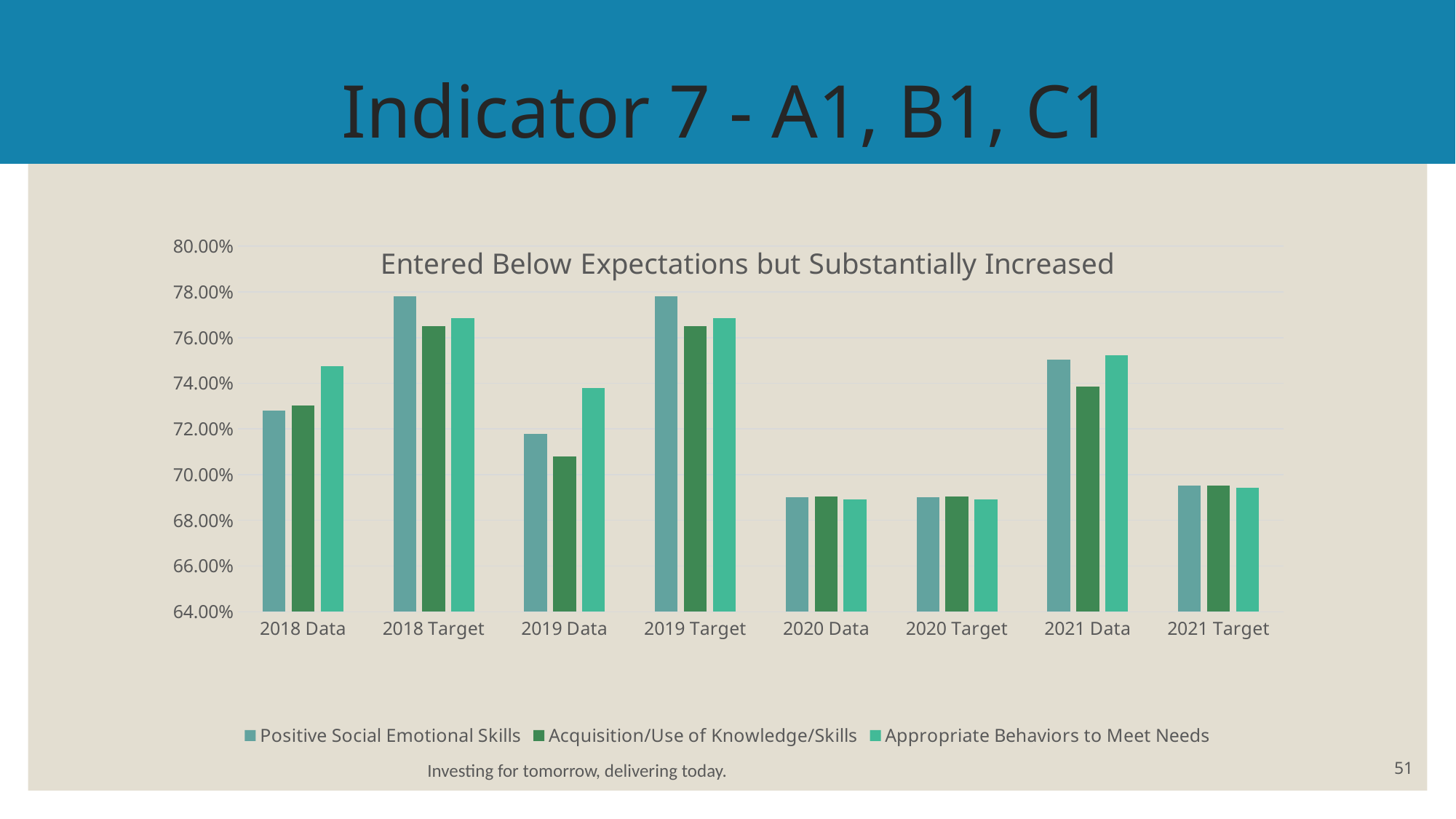
Is the value for Appropriate Behaviors to Meet Needs at 2021 Data greater or less than 74.00%? greater What is the title of the chart? Entered Below Expectations but Substantially Increased At 2019 Data, which is larger: Appropriate Behaviors to Meet Needs or Acquisition/Use of Knowledge/Skills? Appropriate Behaviors to Meet Needs For Positive Social Emotional Skills, which is larger: 2021 Data or 2021 Target? 2021 Data Is the value for Acquisition/Use of Knowledge/Skills at 2019 Data greater or less than 72.00%? less How many series does the chart's legend list? 3 What kind of chart is shown on the slide? Bar chart Is the value for Positive Social Emotional Skills at 2020 Data greater or less than 70.00%? less How many categories are shown along the x axis of the chart? 8 Which series is listed first in the chart's legend? Positive Social Emotional Skills Within the 2018 Data group, which series has the highest value? Appropriate Behaviors to Meet Needs